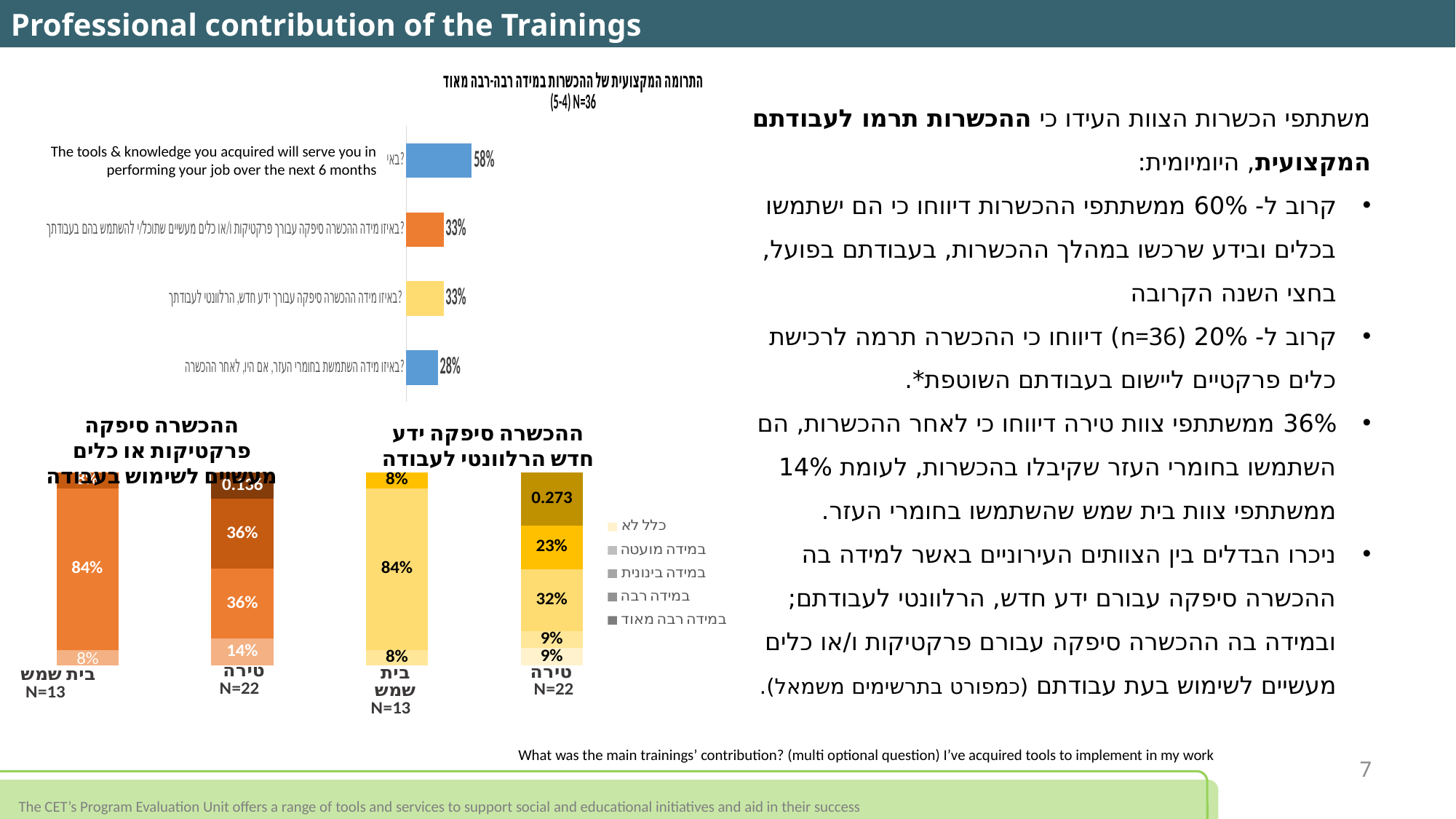
In the bottom-left stacked bar chart (ההכשרה סיפקה פרקטיקות או כלים מעשיים לשימוש בעבודה), what is the value of the bottom segment for טירה (N=22)? 14% In the bottom-right stacked bar chart (ההכשרה סיפקה ידע חדש הרלוונטי לעבודה), what is the value of the 32% segment's neighbour above it for טירה (N=22)? 23% In the top horizontal bar chart, which category has the highest value? The tools & knowledge you acquired will serve you in performing your job over the next 6 months In the top horizontal bar chart, what is the value for 'The tools & knowledge you acquired will serve you in performing your job over the next 6 months'? 58% In the top horizontal bar chart, what is the lowest value shown? 28% How many entries does the legend next to the bottom stacked bar charts list? 5 In the top horizontal bar chart, how many categories (bars) are shown? 4 In the top horizontal bar chart, what is the difference between the highest value (58%) and the lowest value (28%)? 30 percentage points In the top horizontal bar chart, what is the N shown in the chart title? N=36 In the top horizontal bar chart, what is the value for the bottom category about using the support materials after the training (באיזו מידה השתמשת בחומרי העזר)? 28% In the bottom-right stacked bar chart (ההכשרה סיפקה ידע חדש הרלוונטי לעבודה), what is the largest segment value for בית שמש (N=13)? 84% What type of chart is the top chart on the slide? Bar chart